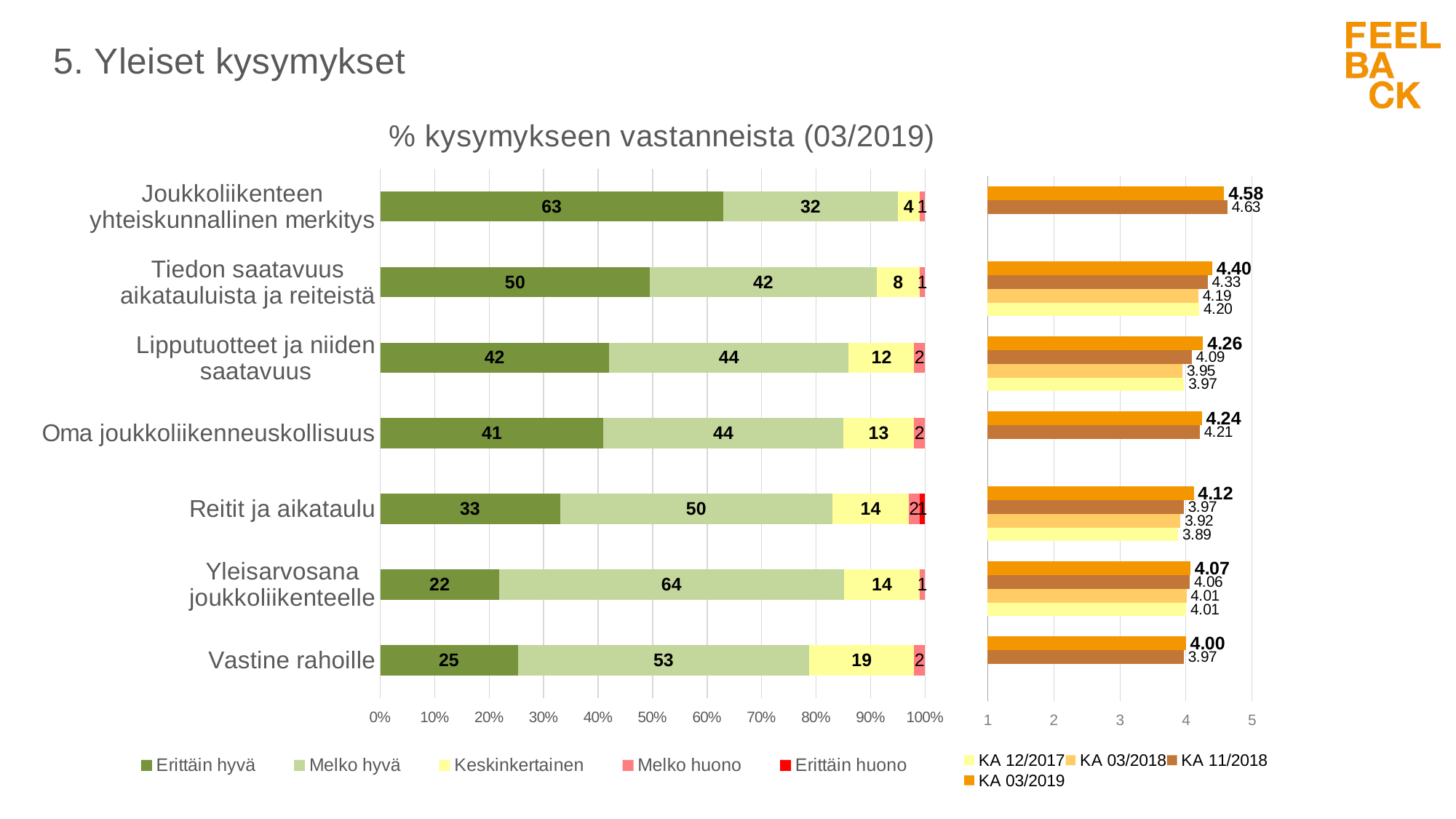
In the left chart '% kysymykseen vastanneista (03/2019)', what is the 'Erittäin hyvä' value for 'Joukkoliikenteen yhteiskunnallinen merkitys'? 63 How many series does the legend of the left chart '% kysymykseen vastanneista (03/2019)' list? 5 In the left chart '% kysymykseen vastanneista (03/2019)', which category has the lowest 'Erittäin hyvä' value? Yleisarvosana joukkoliikenteelle In the right-hand KA chart, what is the 'KA 03/2019' value for 'Tiedon saatavuus aikatauluista ja reiteistä'? 4.40 In the left chart '% kysymykseen vastanneista (03/2019)', which category has the highest 'Erittäin hyvä' value? Joukkoliikenteen yhteiskunnallinen merkitys In the right-hand KA chart, what is the 'KA 12/2017' value for 'Reitit ja aikataulu'? 3.89 In the left chart '% kysymykseen vastanneista (03/2019)', which has the larger 'Keskinkertainen' value: 'Vastine rahoille' or 'Reitit ja aikataulu'? Vastine rahoille What kind of chart is the right-hand chart showing the KA values? bar chart How many series does the legend of the right-hand KA chart list? 4 How many categories are shown in the left chart '% kysymykseen vastanneista (03/2019)'? 7 In the left chart '% kysymykseen vastanneista (03/2019)', what is the 'Melko hyvä' value for 'Yleisarvosana joukkoliikenteelle'? 64 In the left chart '% kysymykseen vastanneista (03/2019)', what is the difference between the 'Melko hyvä' and 'Keskinkertainen' values for 'Vastine rahoille'? 34